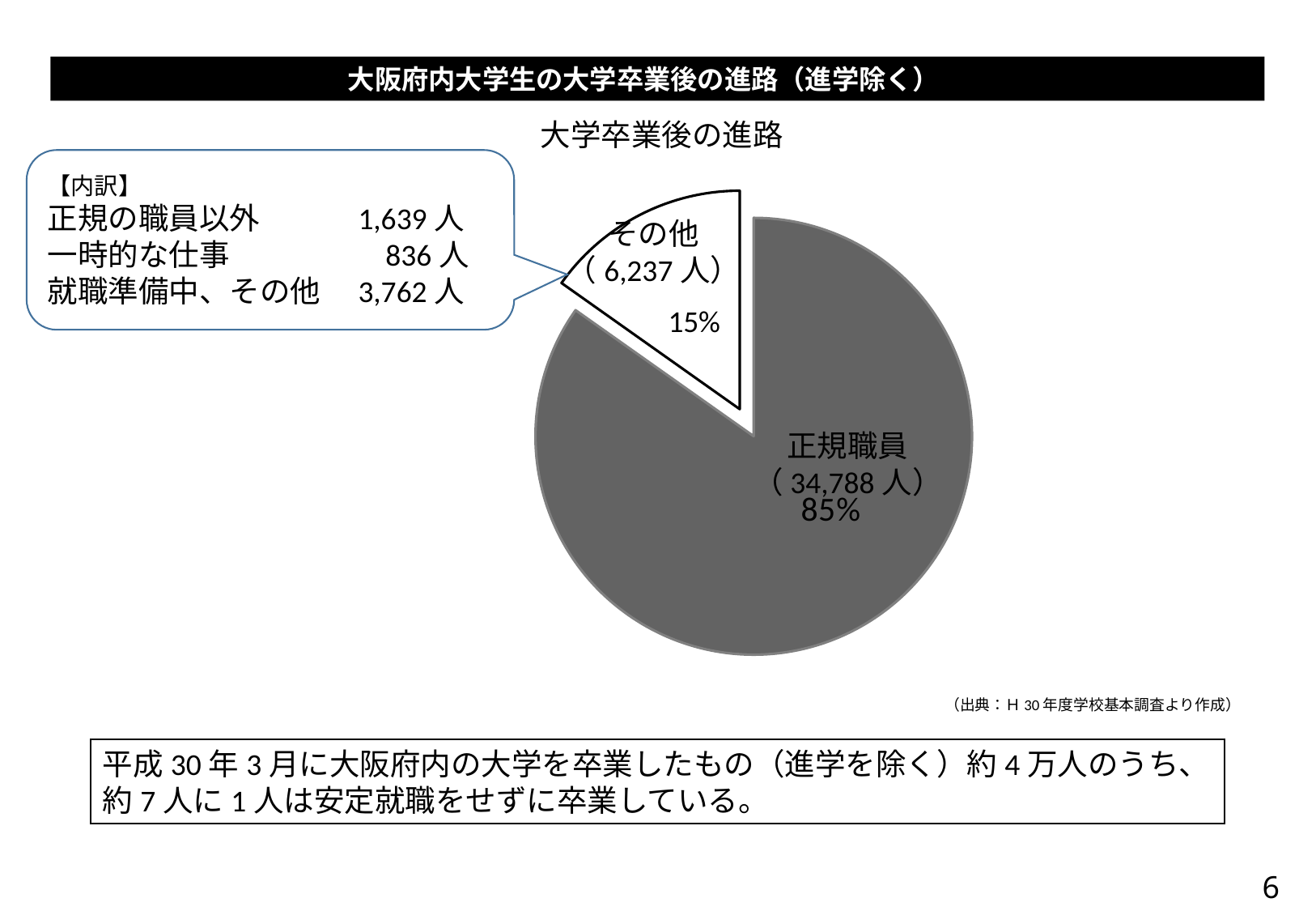
What is the title of the chart? 大学卒業後の進路 What is the difference in people between the 正規職員 slice and the その他 slice? 28,551 人 What share of the pie does 正規職員 represent? 85% What kind of chart is shown on the slide? pie chart Which slice is shown in white and pulled out from the pie? その他 Which slice is the largest? 正規職員 Which slice is the smallest? その他 Which slice is larger, 正規職員 or その他? 正規職員 How many people are in the 正規職員 slice? 34,788 人 How many people are in the その他 slice? 6,237 人 What share of the pie does その他 represent? 15% How many slices does the pie chart have? 2